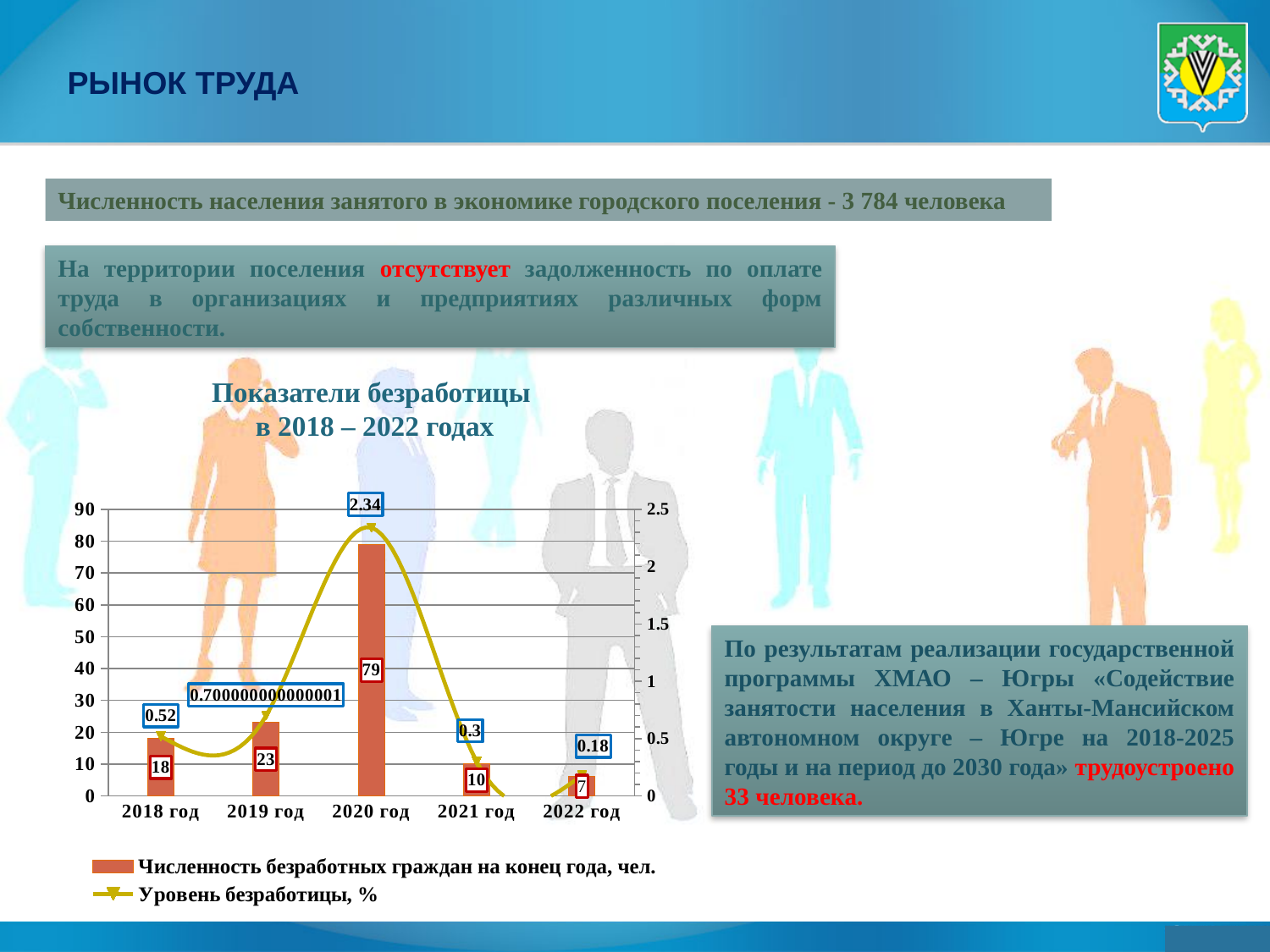
What is the value of 'Уровень безработицы, %' for 2022 год? 0.18 What is the value of 'Уровень безработицы, %' for 2020 год? 2.34 In which year is 'Численность безработных граждан на конец года, чел.' the lowest? 2022 год How many years are shown on the x axis of the chart? 5 In which year is 'Численность безработных граждан на конец года, чел.' the highest? 2020 год What is the title of the chart on the slide? Показатели безработицы в 2018 – 2022 годах Which year has a higher 'Уровень безработицы, %': 2018 год or 2021 год? 2018 год How many series does the chart legend list? 2 What is the value of 'Численность безработных граждан на конец года, чел.' for 2020 год? 79 Does 'Численность безработных граждан на конец года, чел.' rise or fall from 2020 год to 2022 год? fall What is the value of 'Численность безработных граждан на конец года, чел.' for 2019 год? 23 What is the difference between the number of unemployed citizens in 2020 год and 2021 год? 69